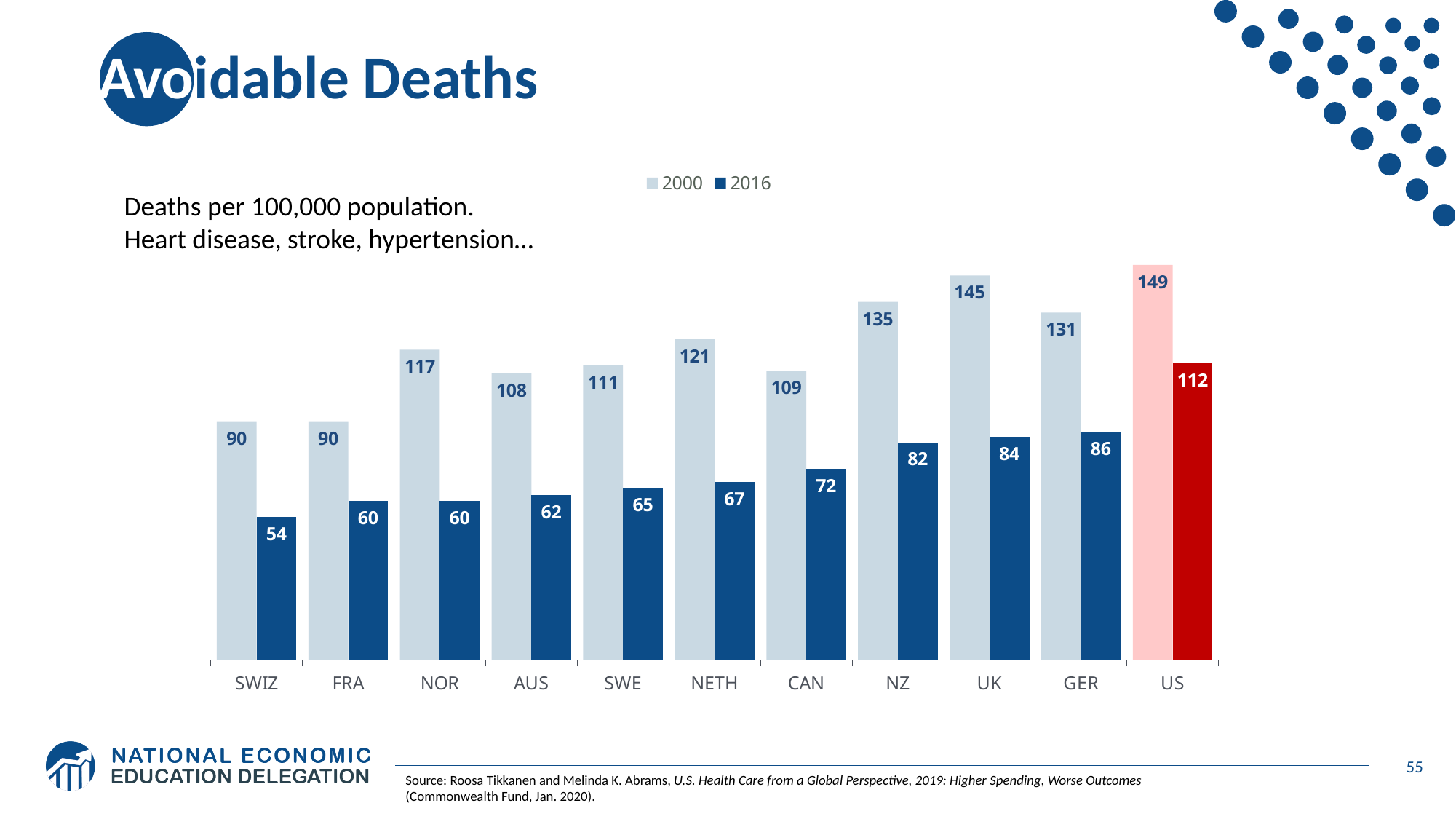
Which is larger, the 2016 value for GER or the 2016 value for NZ? GER What is the 2016 value for the US? 112 What is the difference between the 2000 and 2016 values for the UK? 61 How many series does the legend list? 2 What is the 2016 value for CAN? 72 Which country has the highest 2000 value? US What is the 2000 value for NOR? 117 Which country has the lowest 2016 value? SWIZ Which country's bars are coloured red instead of blue? US Do the 2016 values generally rise or fall from SWIZ to US along the x axis? Rise How many countries are shown on the x axis? 11 What kind of chart is shown on the slide? Bar chart